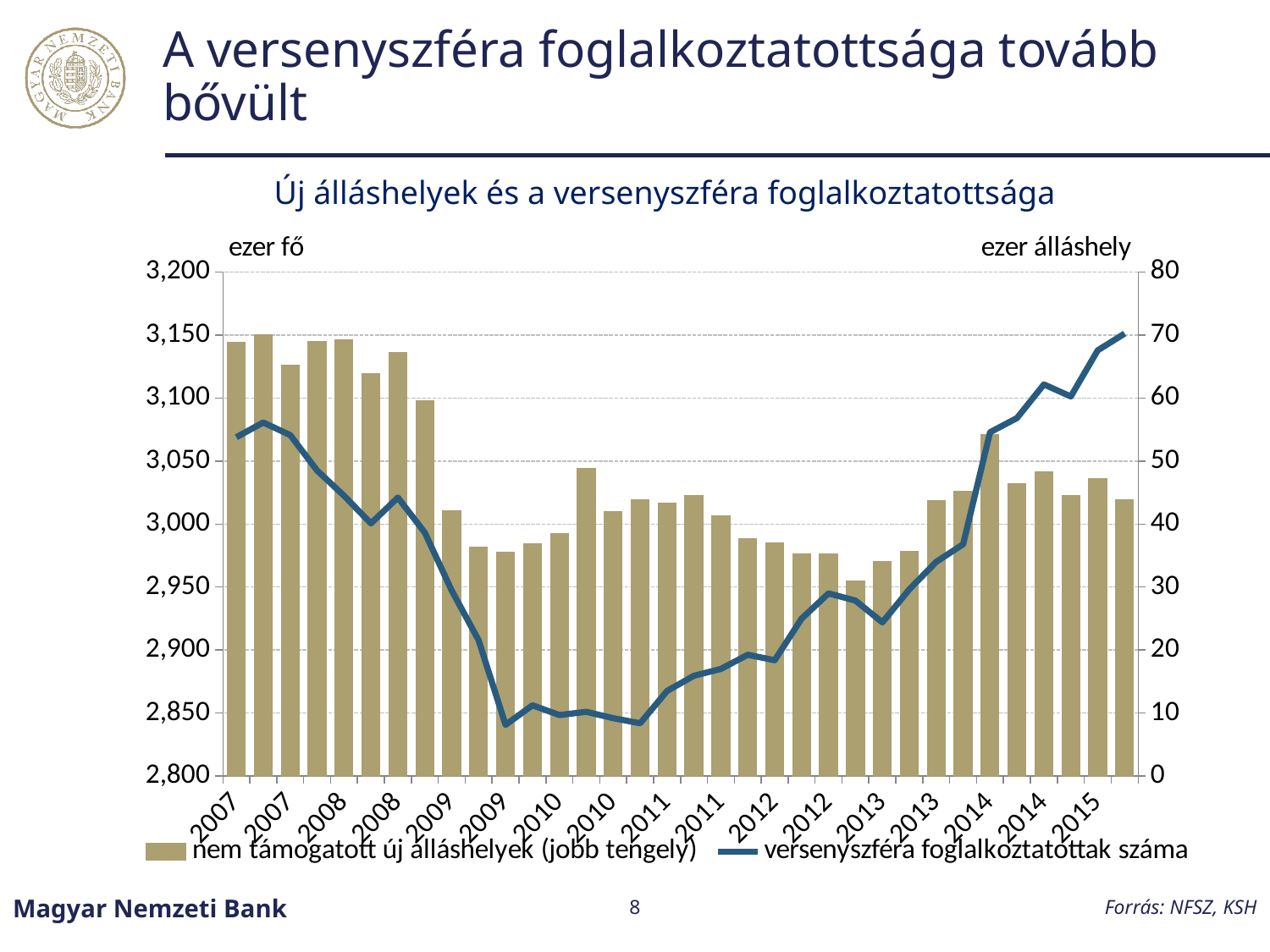
Is the lowest bar for nem támogatott új álláshelyek (around 2013) greater or less than 40 on the right axis? less What is the title of the chart? Új álláshelyek és a versenyszféra foglalkoztatottsága Is the last bar (2015) for nem támogatott új álláshelyek higher or lower than the first bar (2007)? lower Is the lowest point of the versenyszféra foglalkoztatottak száma line (around 2009) greater or less than 2,900? less Is the value of the versenyszféra foglalkoztatottak száma line at the first 2007 point greater or less than 3,050? greater What kind of chart is shown on the slide? A combined bar and line chart Which series is plotted on the right axis according to the legend? nem támogatott új álláshelyek (jobb tengely) How many series does the legend list? 2 Does the versenyszféra foglalkoztatottak száma line rise or fall between 2007 and 2009? fall Does the versenyszféra foglalkoztatottak száma line rise or fall between 2013 and 2015? rise